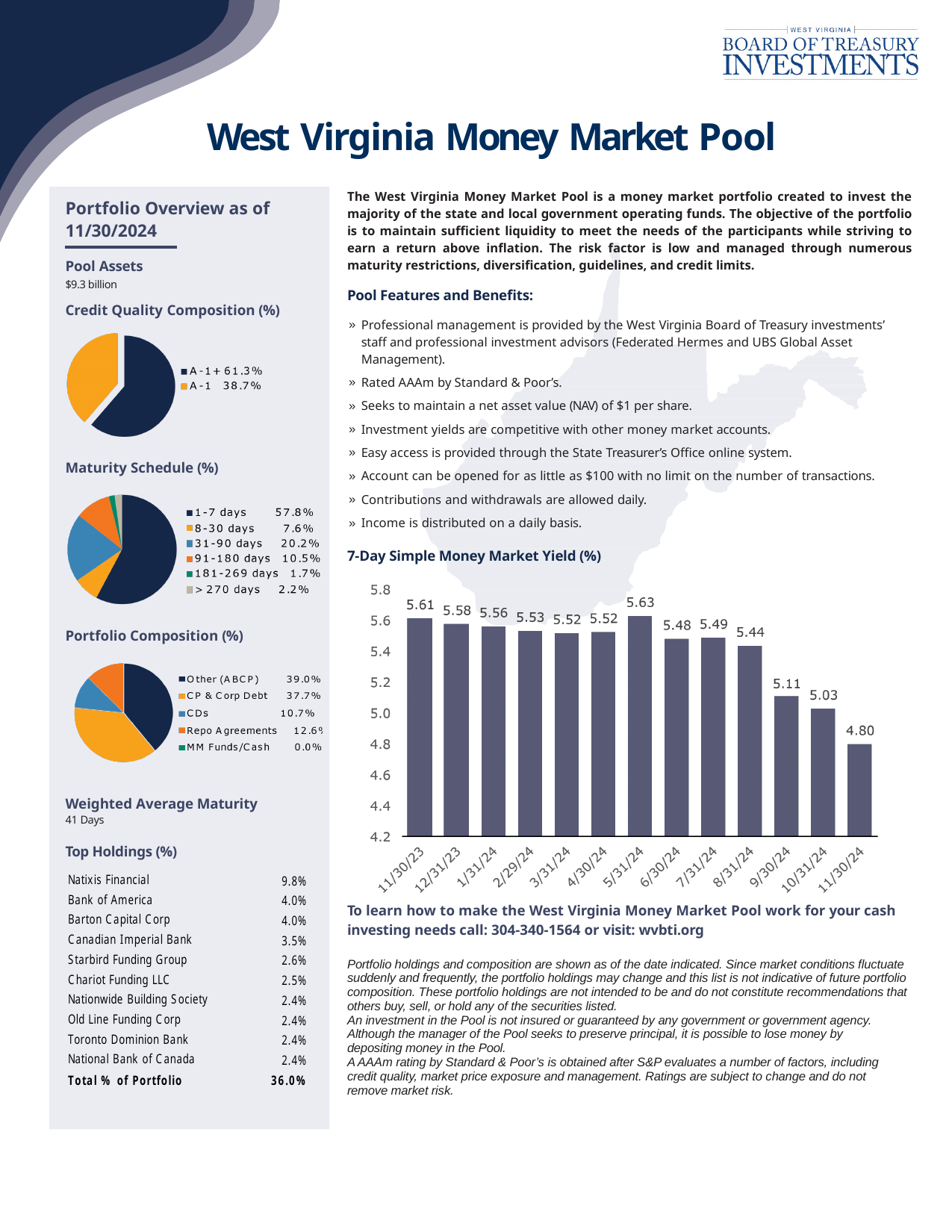
In the 7-Day Simple Money Market Yield (%) chart, what is the value for 5/31/24? 5.63 In the Credit Quality Composition (%) pie chart, what share is A-1+? 61.3% In the 7-Day Simple Money Market Yield (%) chart, what is the difference between the values for 11/30/23 and 11/30/24? 0.81 In the 7-Day Simple Money Market Yield (%) chart, which date has the highest yield? 5/31/24 In the Maturity Schedule (%) pie chart, which category has the largest share? 1-7 days In the Maturity Schedule (%) pie chart, what is the value for 31-90 days? 20.2% In the Portfolio Composition (%) pie chart, which is larger, CDs or Repo Agreements? Repo Agreements In the 7-Day Simple Money Market Yield (%) chart, which date has the lowest yield? 11/30/24 What kind of chart is the 7-Day Simple Money Market Yield (%) chart? Bar chart In the 7-Day Simple Money Market Yield (%) chart, how many bars are plotted? 13 In the 7-Day Simple Money Market Yield (%) chart, do the values generally rise or fall from 5/31/24 to 11/30/24? Fall In the 7-Day Simple Money Market Yield (%) chart, what is the value for 11/30/24? 4.80